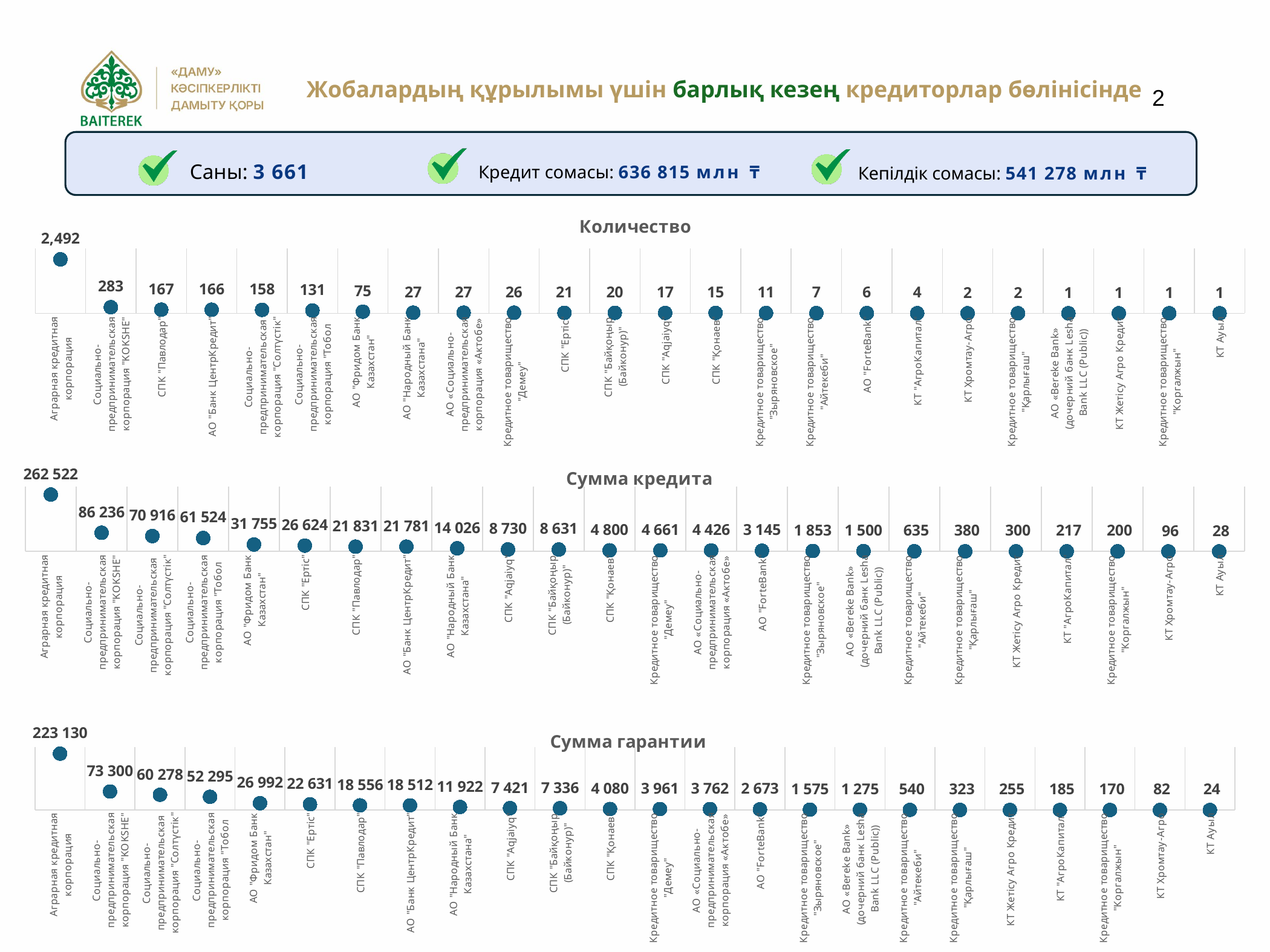
In the "Количество" chart, what is the difference between the values for СПК "KOKSHE" and АО "Банк ЦентрКредит"? 117 How many categories are plotted in the "Сумма гарантии" chart? 24 In the "Сумма гарантии" chart, which is larger: the value for СПК "Aqjaiyq" or the value for СПК "Байқоңыр"? СПК "Aqjaiyq" In the "Сумма кредита" chart, which is larger: the value for СПК "Ертіс" or the value for СПК "Павлодар"? СПК "Ертіс" In the "Сумма кредита" chart, what is the difference between the values for Аграрная кредитная корпорация and СПК "KOKSHE"? 176 286 In the "Сумма кредита" chart, which category has the lowest value? КТ Ауыл In the "Сумма гарантии" chart, what is the value for АО "ForteBank"? 2 673 In the "Сумма кредита" chart, what is the value for АО "Фридом Банк Казахстан"? 31 755 In the "Сумма гарантии" chart, what is the value for Кредитное товарищество "Демеу"? 3 961 Do the values in the "Количество" chart rise or fall from left to right along the x axis? fall In the "Количество" chart, which category has the highest value? Аграрная кредитная корпорация In the "Количество" chart, what is the value for СПК "Павлодар"? 167